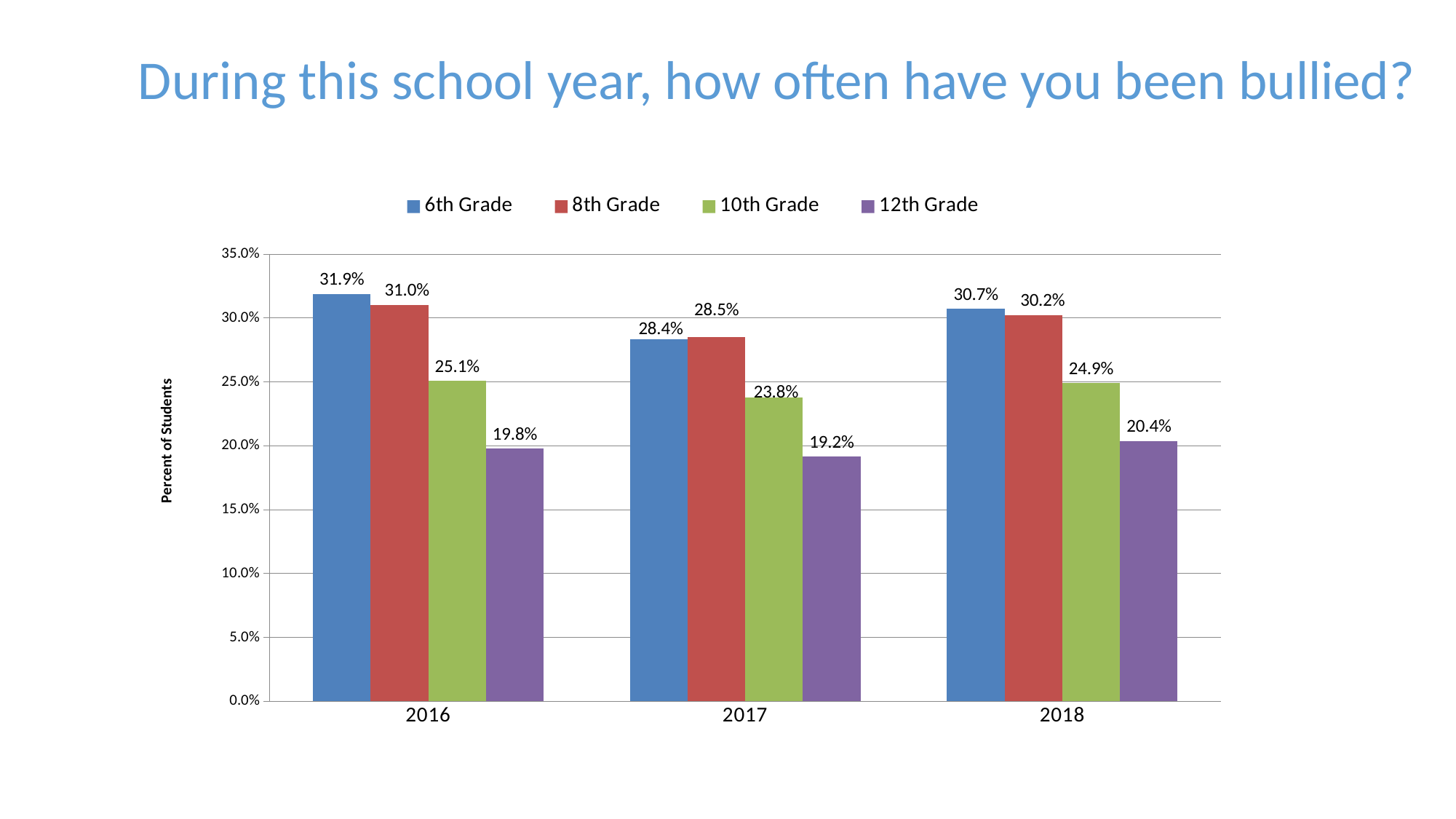
What is the value for 12th Grade in 2017? 19.2% Does the 10th Grade value rise or fall from 2016 to 2017? Fall How many years are shown on the x axis? 3 What kind of chart is shown on the slide? Bar chart Which is larger in 2018, the 6th Grade value or the 8th Grade value? 6th Grade What is the value for 6th Grade in 2016? 31.9% Which grade has the lowest value in 2018? 12th Grade What is the difference between the 6th Grade and 12th Grade values in 2016? 12.1% How many series does the legend list? 4 What is the label on the vertical axis? Percent of Students Which grade has the highest value in 2017? 8th Grade What is the value for 10th Grade in 2018? 24.9%